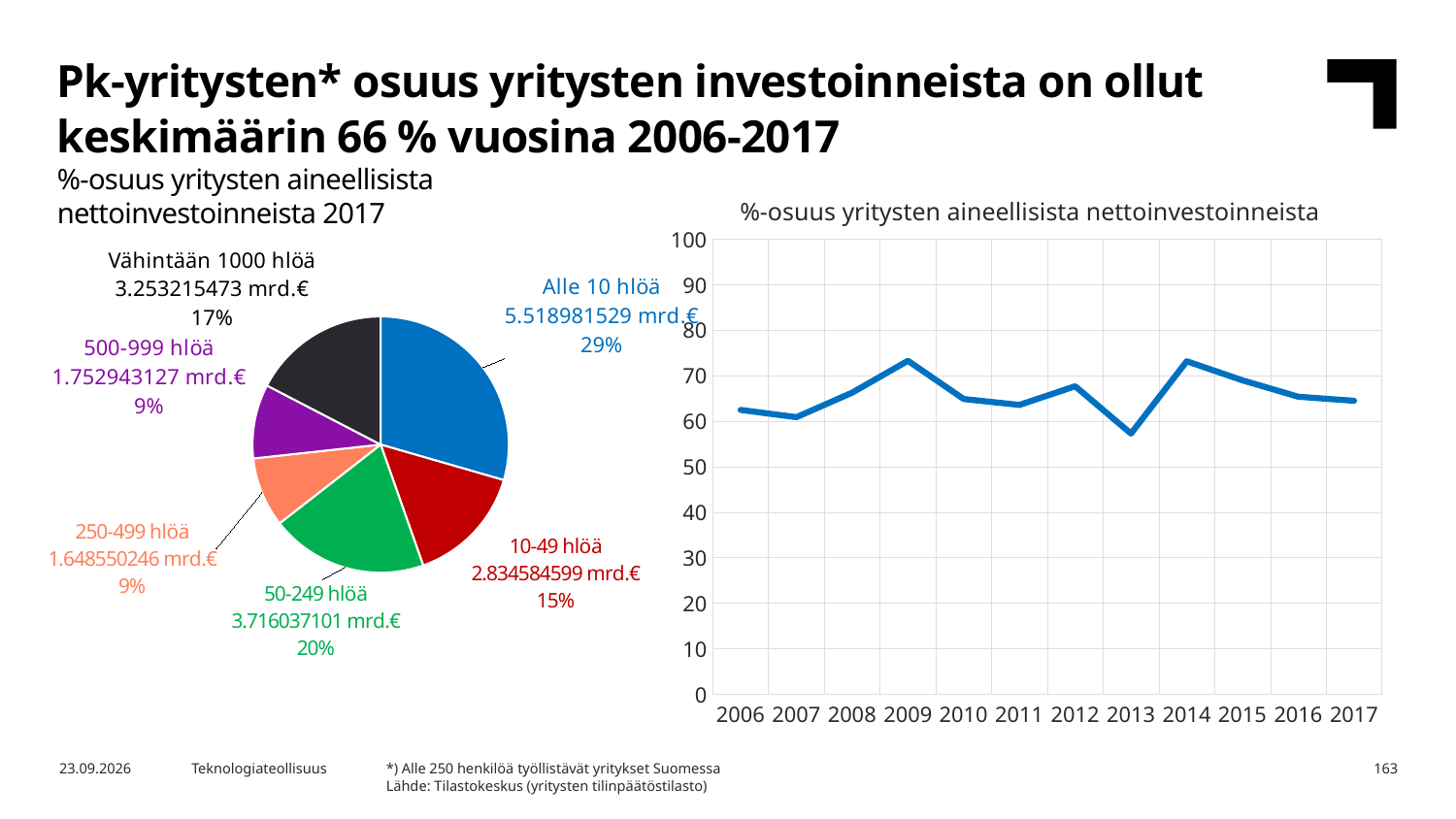
In the line chart on the right, is the value for 2009 greater or less than 70? greater In the pie chart on the left, what is the percentage share of 'Vähintään 1000 hlöä'? 17% In the pie chart on the left, how many slices does the pie have? 6 In the pie chart on the left, which category has the largest share? Alle 10 hlöä In the line chart on the right, which year has the lowest value? 2013 In the pie chart on the left, which is larger: the share of '10-49 hlöä' or the share of '50-249 hlöä'? 50-249 hlöä In the pie chart on the left, what value in mrd.€ is shown for '50-249 hlöä'? 3.716037101 mrd.€ In the pie chart on the left, what is the difference in percentage points between the share of 'Alle 10 hlöä' and the share of '10-49 hlöä'? 14 In the line chart on the right, how many years are shown on the x axis? 12 In the pie chart on the left, what percentage share is shown for 'Alle 10 hlöä'? 29% In the line chart on the right, is the value for 2013 greater or less than 60? less What kind of chart is the chart on the right of the slide? Line chart